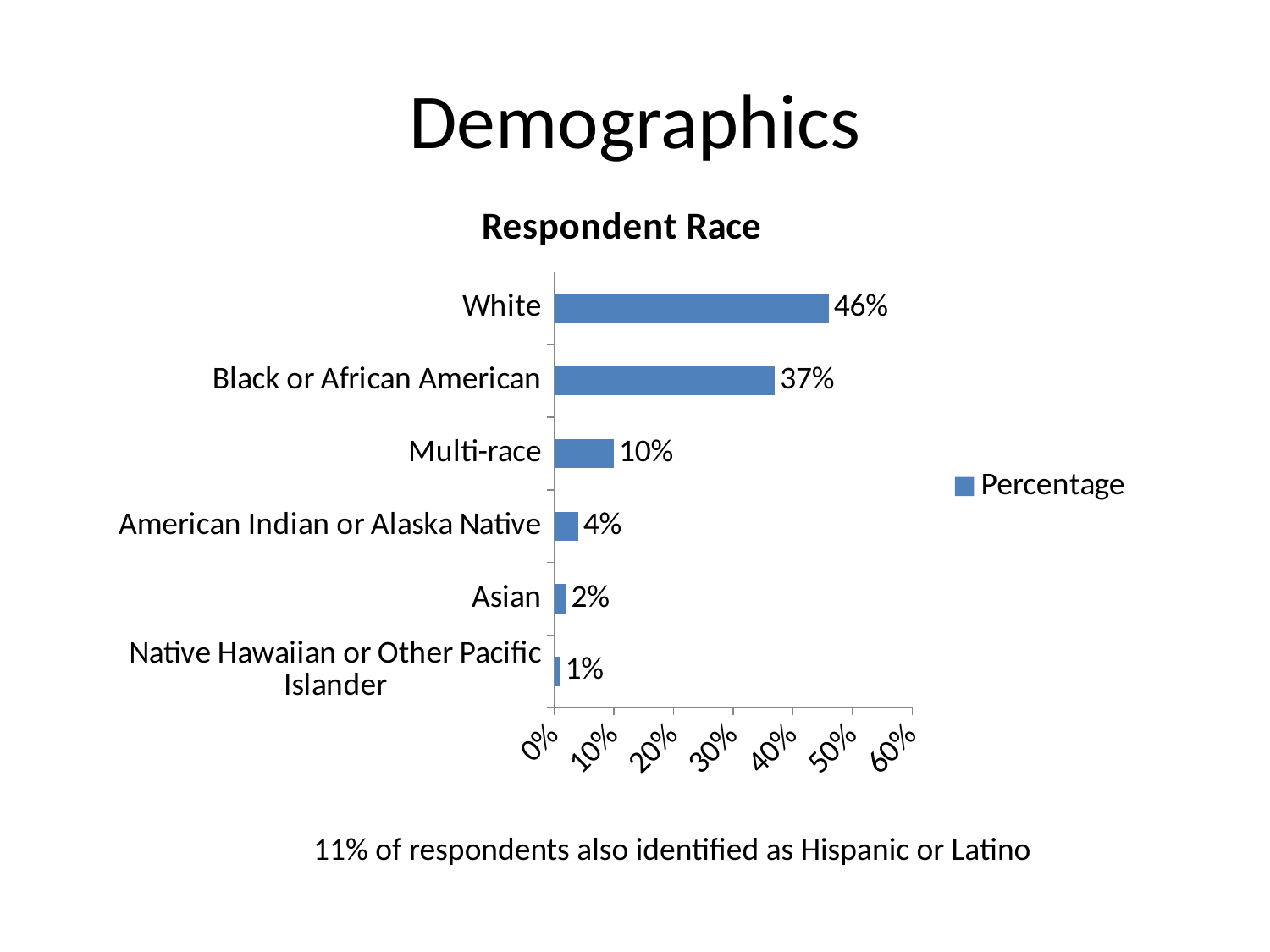
What is the title of the chart? Respondent Race What is the value for American Indian or Alaska Native? 4% How many series does the legend list? 1 What is the difference between the White and Black or African American percentages? 9% What percentage of respondents are Black or African American? 37% What kind of chart is shown on the slide? Bar chart What percentage of respondents are White? 46% Which race category has the lowest percentage? Native Hawaiian or Other Pacific Islander Which race category has the highest percentage? White Which is larger, the value for Asian or the value for American Indian or Alaska Native? American Indian or Alaska Native How many race categories are shown in the chart? 6 What is the value for Multi-race? 10%